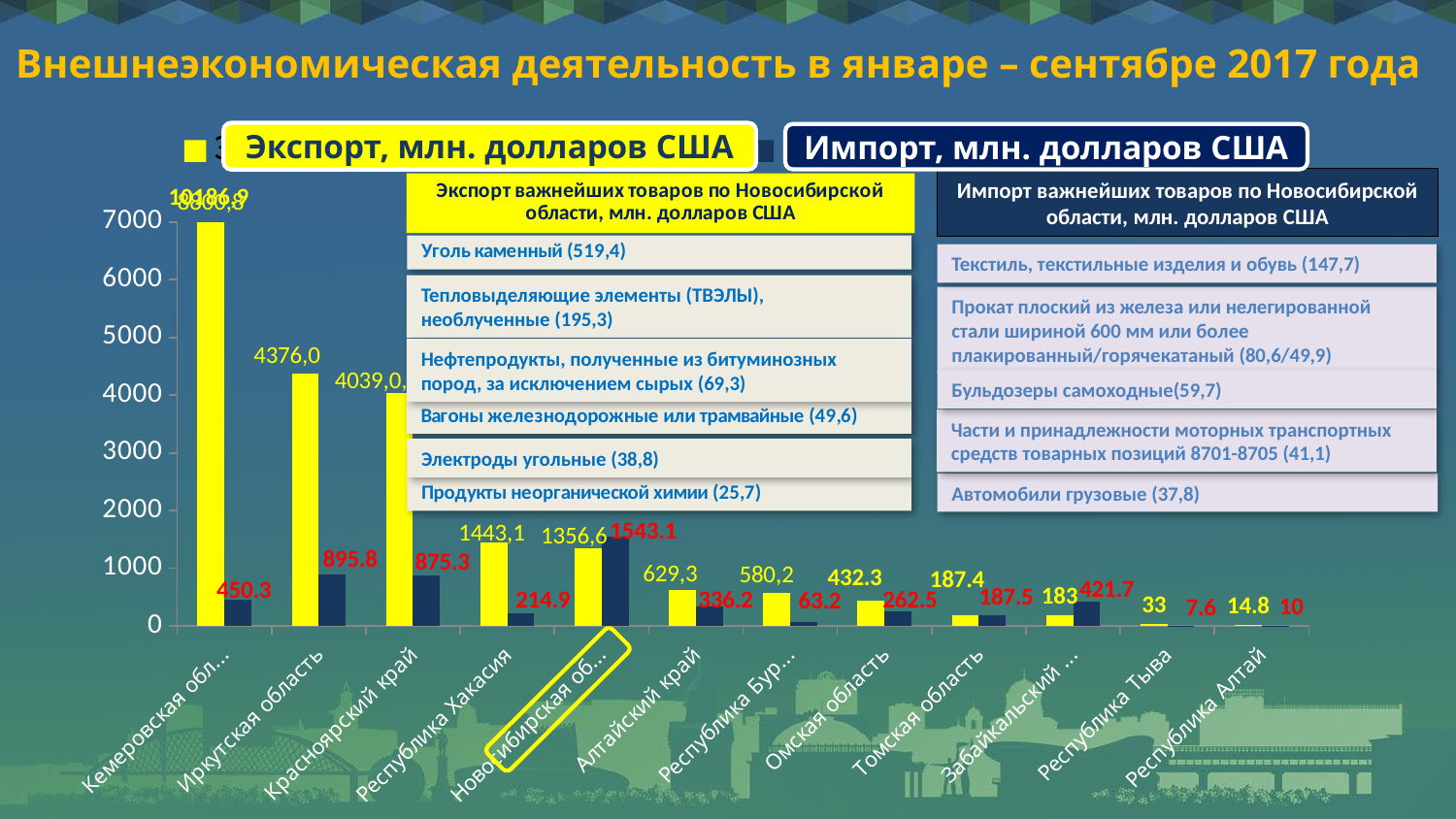
Which region has the lowest export value? Республика Алтай What is the import value (Импорт) for Иркутская область? 895.8 What is the difference between the export values of Республика Хакасия (1443,1) and Новосибирская область (1356,6)? 86,5 How many regions are shown along the x axis of the chart? 12 How many series does the chart legend list? 2 For Новосибирская область, which is larger: export or import? Import What is the export value (Экспорт) for Иркутская область? 4376,0 What kind of chart is shown on the slide? Bar chart What is the export value (Экспорт) for Алтайский край? 629,3 Is the export value for Кемеровская область greater or less than 6000? greater What is the import value (Импорт) for Новосибирская область? 1543.1 Which region has the highest import value? Новосибирская область